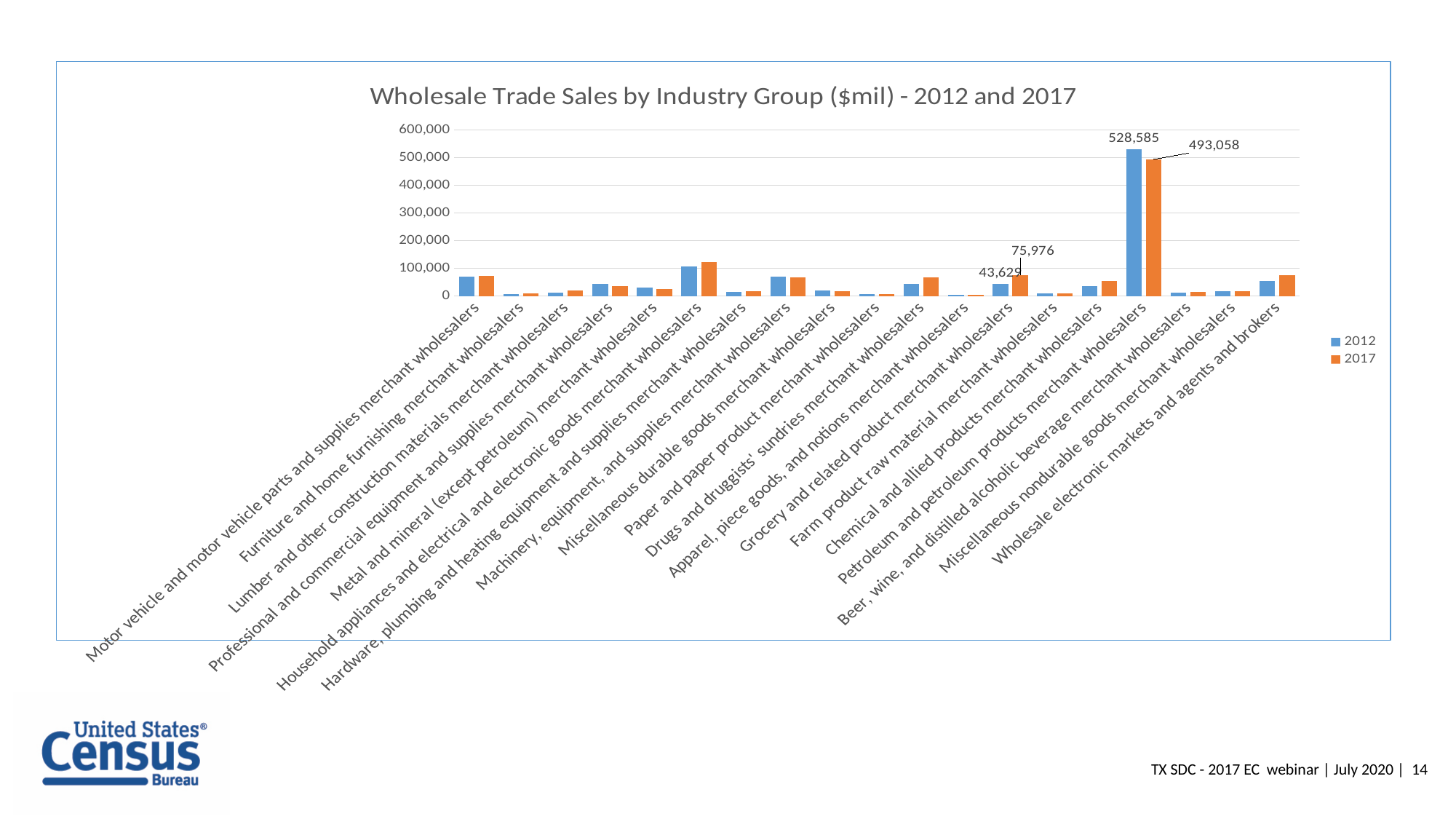
What is the 2017 value for Grocery and related product merchant wholesalers? 75,976 Which industry group has the highest 2012 sales? Petroleum and petroleum products merchant wholesalers What kind of chart is shown on the slide? Bar chart By how much did sales for Grocery and related product merchant wholesalers rise from 2012 to 2017? 32,347 What is the 2017 value for Petroleum and petroleum products merchant wholesalers? 493,058 What is the 2012 value for Grocery and related product merchant wholesalers? 43,629 For Petroleum and petroleum products merchant wholesalers, which year has the larger value, 2012 or 2017? 2012 By how much did sales for Petroleum and petroleum products merchant wholesalers fall from 2012 to 2017? 35,527 How many series does the legend list? 2 How many industry groups are shown on the x axis? 19 What is the 2012 value for Petroleum and petroleum products merchant wholesalers? 528,585 Is the 2017 value for Household appliances and electrical and electronic goods merchant wholesalers greater or less than 100,000? greater